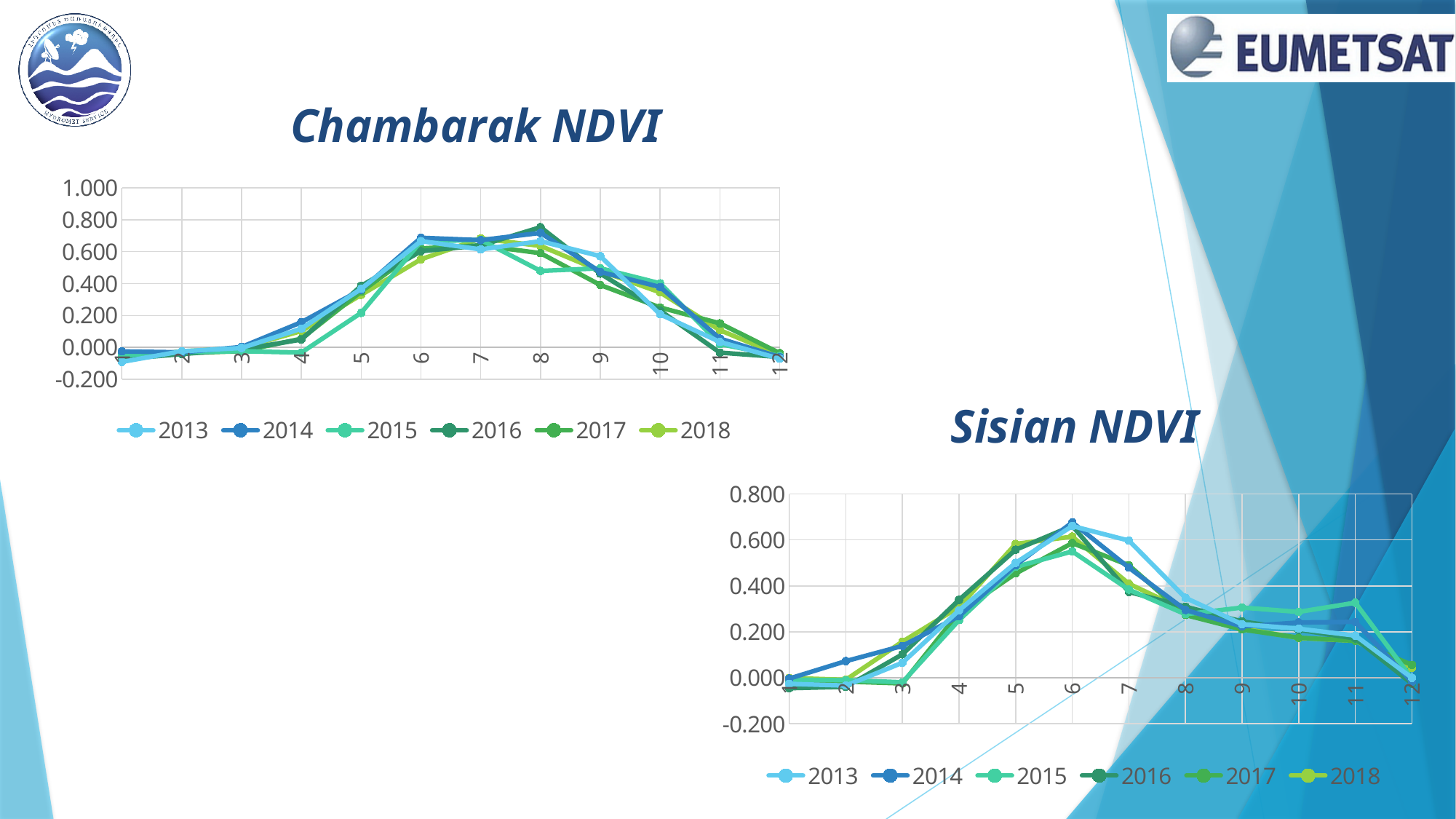
In the Sisian NDVI chart, is the value for 2015 at month 11 greater or less than 0.200? greater In the Sisian NDVI chart, at month 11, which series has the larger value: 2015 or 2014? 2015 How many points along the x axis does the Chambarak NDVI chart have? 12 What is the title of the chart in the lower right of the slide? Sisian NDVI In the Sisian NDVI chart, at which month does the 2014 series reach its highest value? 6 What kind of chart is the Chambarak NDVI chart? line chart How many series does the legend of the Sisian NDVI chart list? 6 In the Chambarak NDVI chart, at month 8, which series has the larger value: 2016 or 2015? 2016 In the Chambarak NDVI chart, is the value for 2015 at month 5 greater or less than 0.400? less In the Chambarak NDVI chart, is the value for 2016 at month 8 greater or less than 0.600? greater In the Chambarak NDVI chart, do the values for 2016 rise or fall from month 8 to month 12? fall